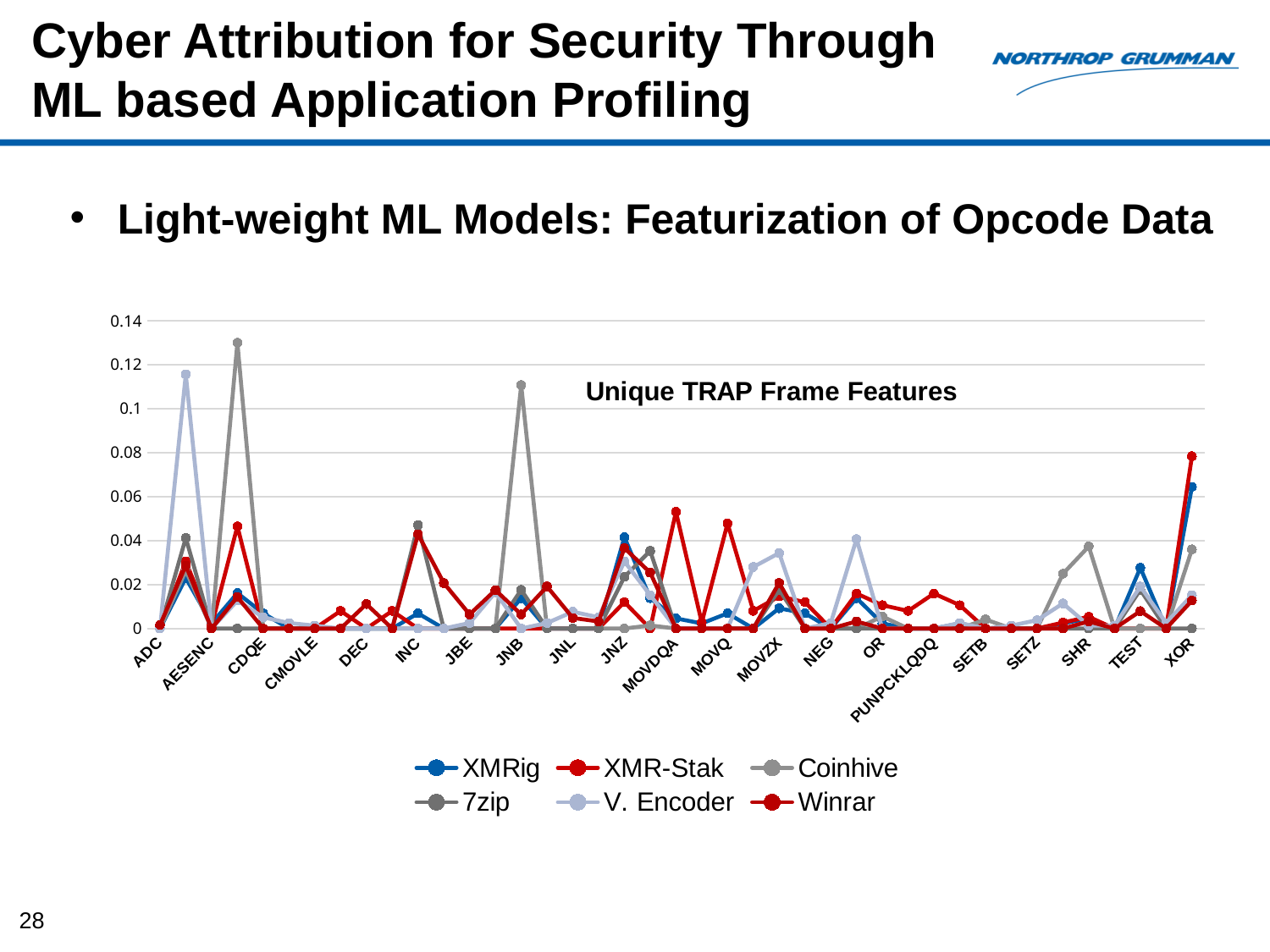
How many series does the legend of the chart list? 6 What kind of chart is shown on the slide? line chart Is the value for V. Encoder at AESENC greater or less than 0.1? less Is the value for XMRig at XOR greater or less than 0.04? greater Which is larger for V. Encoder: the value at AESENC or the value at MOVZX? MOVZX What is the title shown inside the chart? Unique TRAP Frame Features At which category does the XMRig series reach its highest value? XOR Is the value for XMRig at JNZ greater or less than 0.02? greater Which series in the legend is drawn in light blue? V. Encoder Which is larger for XMRig: the value at XOR or the value at JNZ? XOR